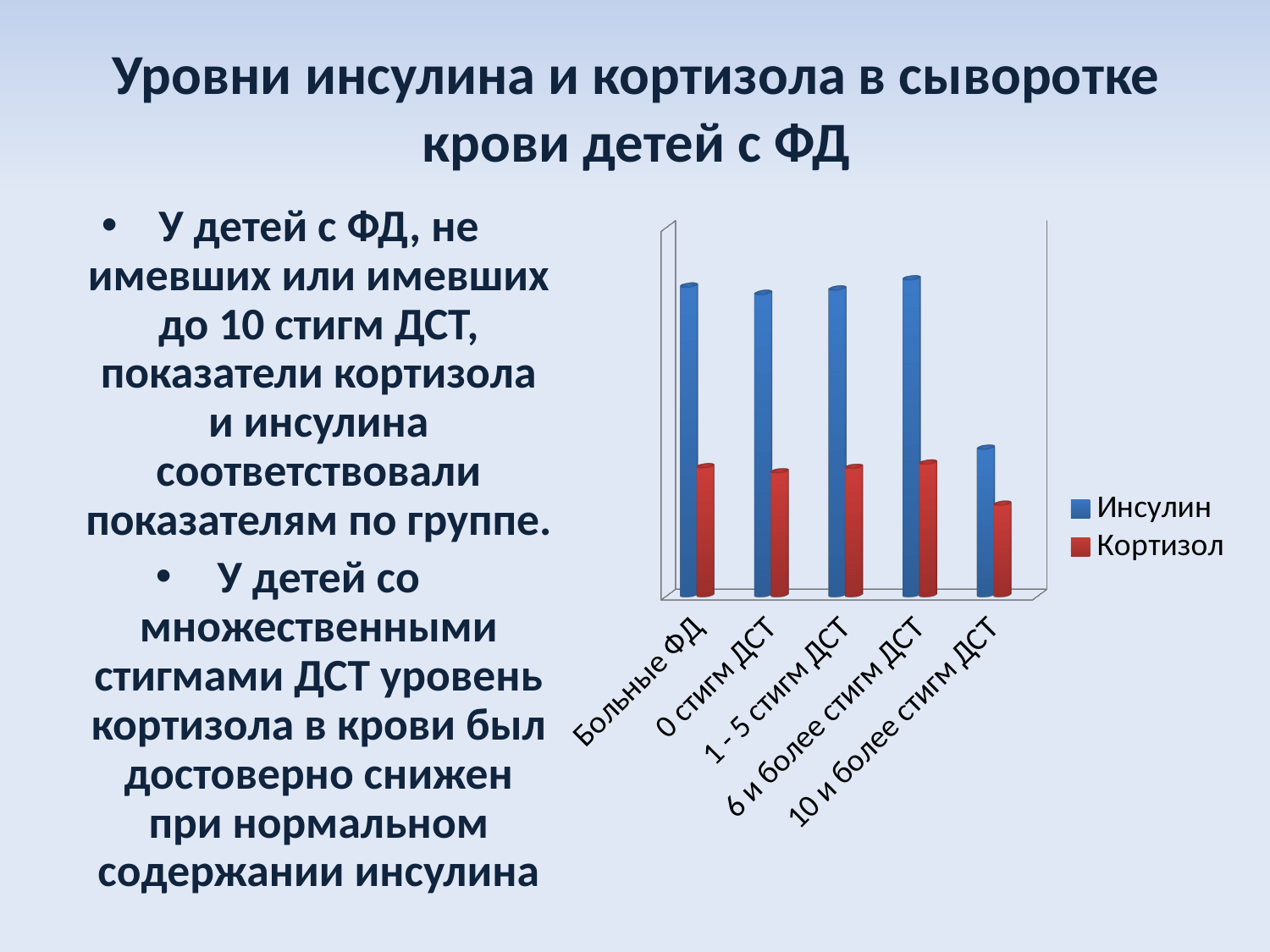
Which is larger: the Кортизол value for 0 стигм ДСТ or the Кортизол value for 10 и более стигм ДСТ? 0 стигм ДСТ Which category has the lowest Кортизол value? 10 и более стигм ДСТ What are the two series named in the chart legend? Инсулин and Кортизол Which colour represents Кортизол in the chart? Red How many categories are shown on the x axis of the chart? 5 What kind of chart is shown on the slide? Bar chart Which category has the lowest Инсулин value? 10 и более стигм ДСТ Which is larger: the Инсулин value for Больные ФД or the Инсулин value for 10 и более стигм ДСТ? Больные ФД Does the Кортизол value rise or fall from 6 и более стигм ДСТ to 10 и более стигм ДСТ? Fall Which category has the highest Инсулин value? 6 и более стигм ДСТ In the category Больные ФД, which is larger: Инсулин or Кортизол? Инсулин How many series does the chart legend list? 2